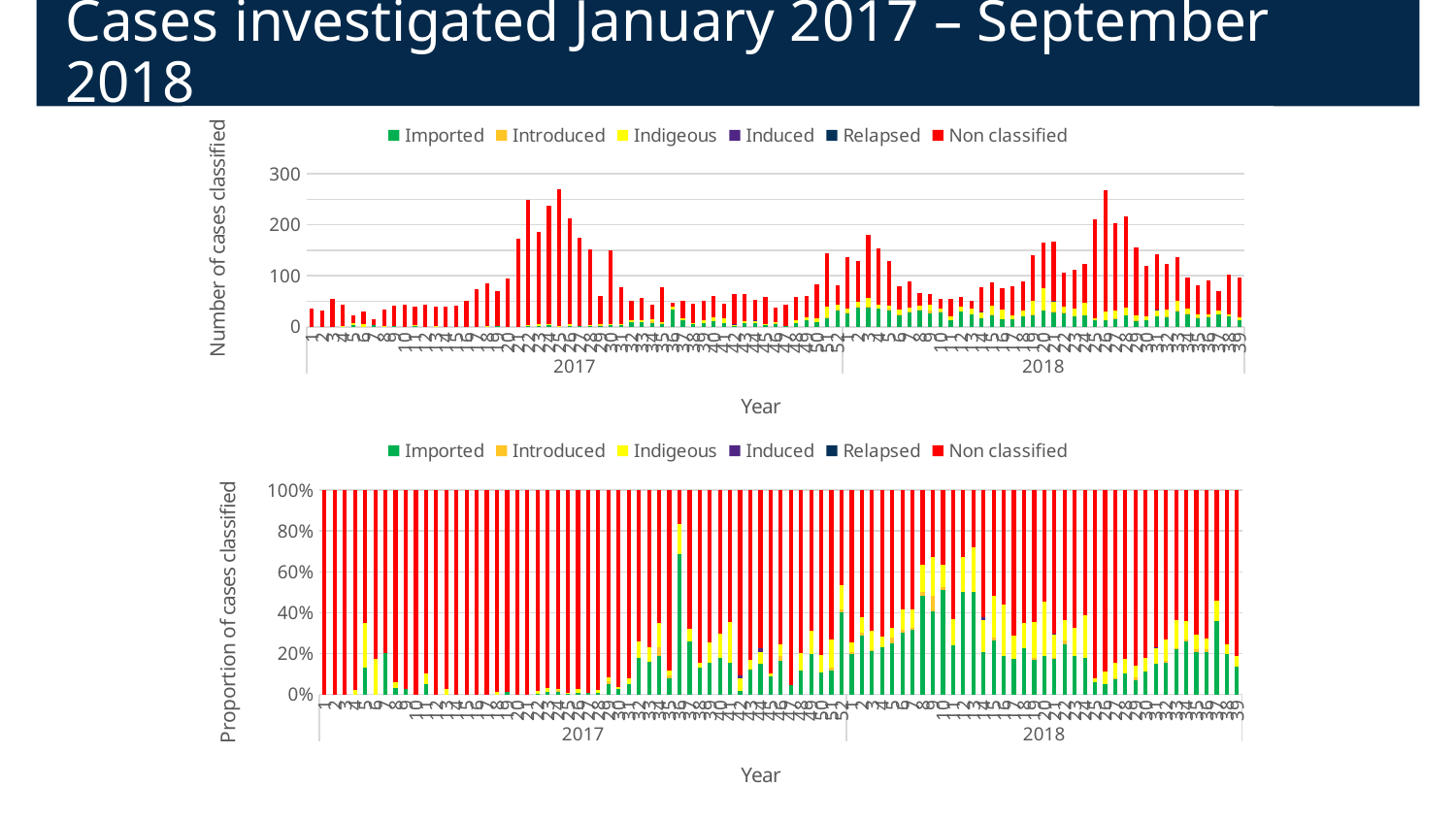
How many years are labelled along the x axis of the top chart? 2 How many series does the legend of the top chart list? 6 In the top chart, is the value of the tallest bar greater or less than 200? greater How many series does the legend of the bottom chart list? 6 What is the title of the vertical axis of the bottom chart? Proportion of cases classified What kind of chart is the bottom chart, 'Proportion of cases classified'? bar chart In the top chart, is the value of the tallest bar in 2018 greater or less than 200? greater In the top chart, which series is shown in red? Non classified In the bottom chart, which series accounts for the largest share of cases in most weeks? Non classified What kind of chart is the top chart, 'Number of cases classified'? bar chart